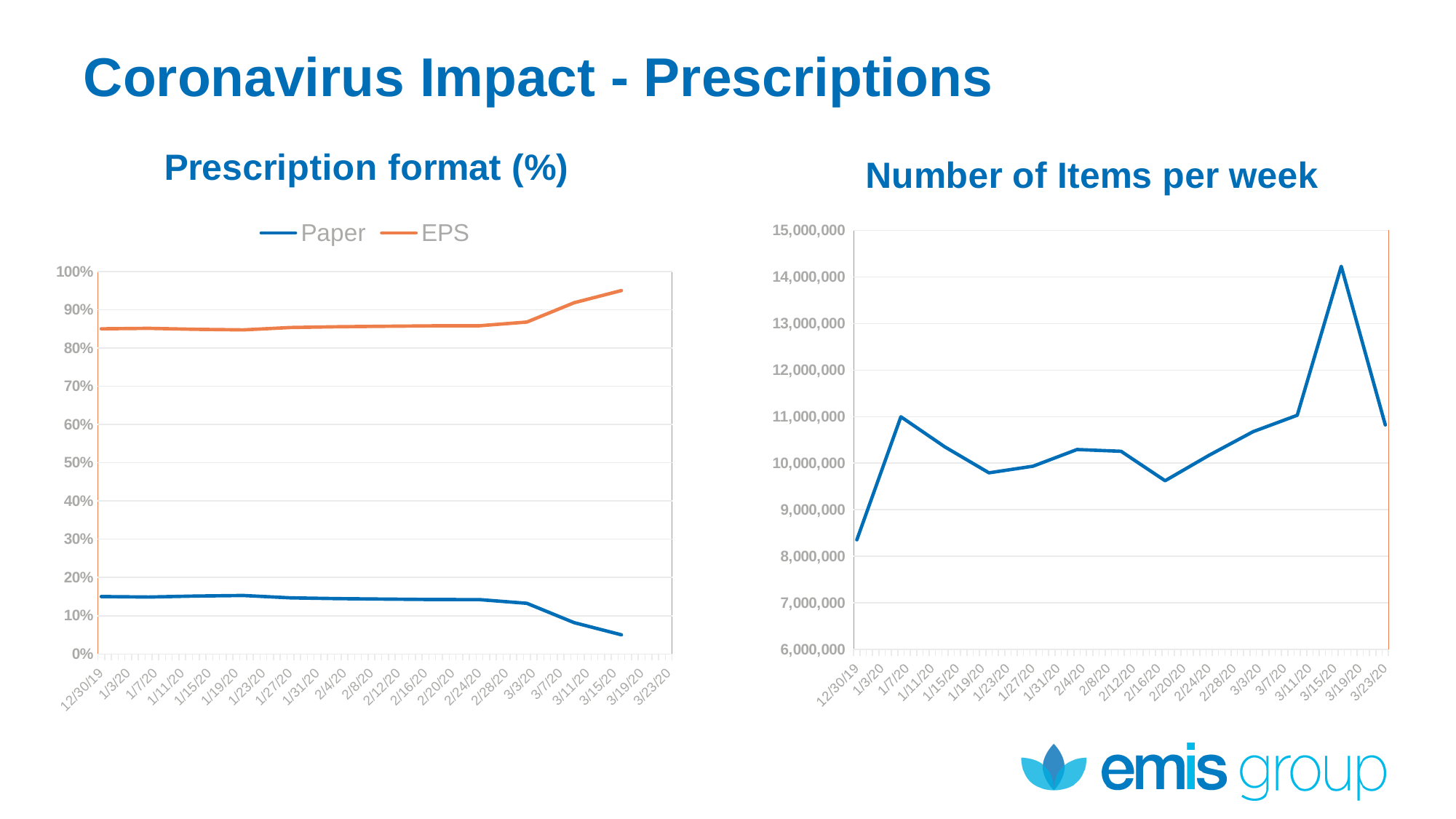
How many series does the legend of the 'Prescription format (%)' chart list? 2 In the 'Prescription format (%)' chart, is the EPS value at 12/30/19 greater or less than 80%? greater What are the two series named in the legend of the 'Prescription format (%)' chart? Paper and EPS In the 'Prescription format (%)' chart, is the Paper value at the last plotted point greater or less than 10%? less In the 'Number of Items per week' chart, which date has the lowest value? 12/30/19 What kind of chart is the 'Number of Items per week' chart on the right? line chart In the 'Prescription format (%)' chart, which series is higher at 12/30/19, Paper or EPS? EPS In the 'Prescription format (%)' chart, does the Paper line rise or fall from 12/30/19 to the end of the series? falls In the 'Number of Items per week' chart, is the value at 12/30/19 greater or less than 9,000,000? less In the 'Prescription format (%)' chart, does the EPS line rise or fall from 12/30/19 to the end of the series? rises What kind of chart is the 'Prescription format (%)' chart on the left? line chart